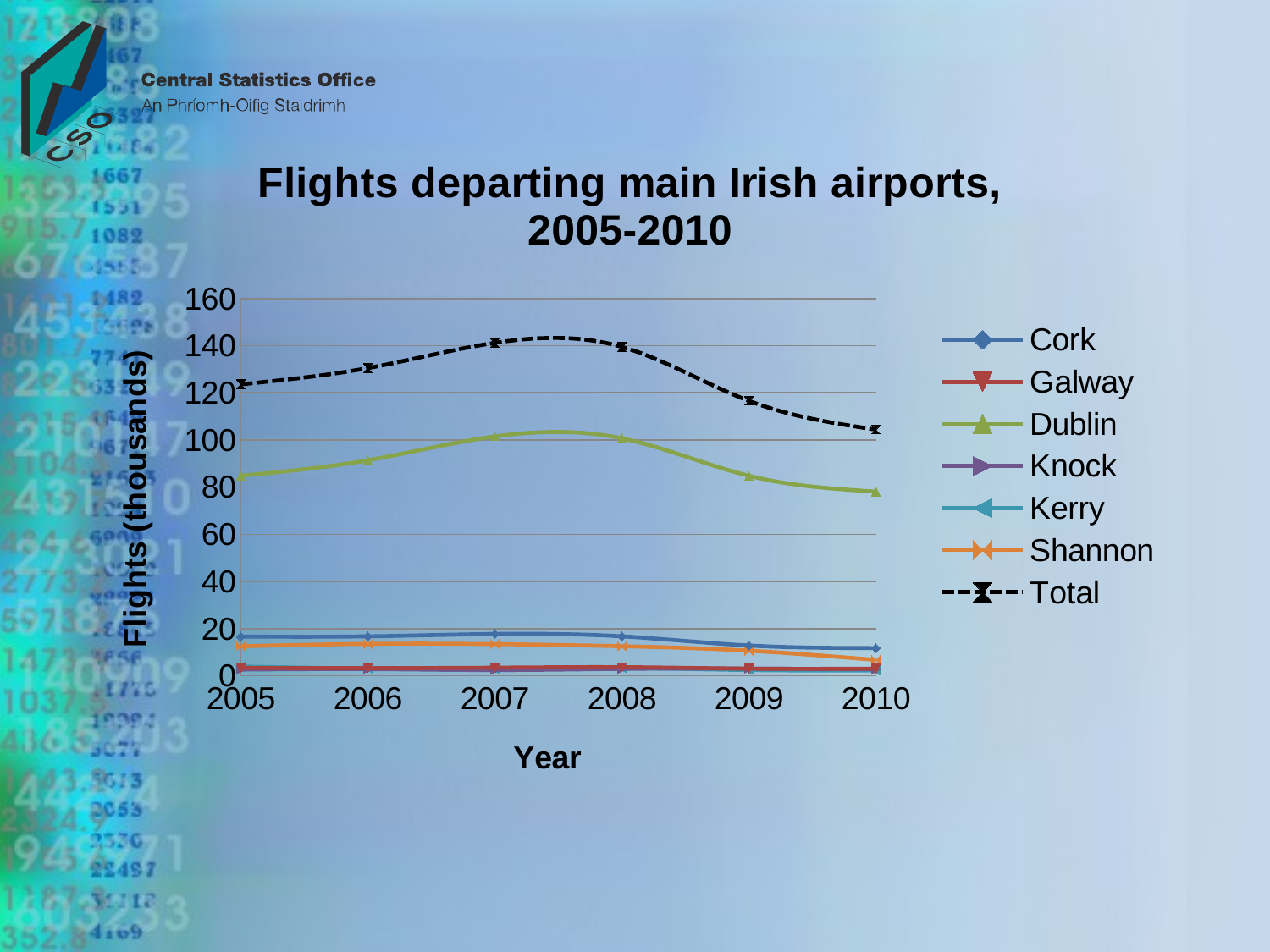
In which year is the Total line at its lowest? 2010 Which is larger, the Total value in 2006 or in 2009? 2006 How many years are plotted along the x axis? 6 How many series does the legend list? 7 What kind of chart is shown on the slide? line chart Which airport has the highest line on the chart? Dublin Is the value for Total in 2009 greater or less than 100? greater Does the Total line rise or fall from 2008 to 2010? fall What is the label on the y axis? Flights (thousands) Is the value for Dublin in 2005 greater or less than 100? less Is the value for Total in 2010 greater or less than 120? less